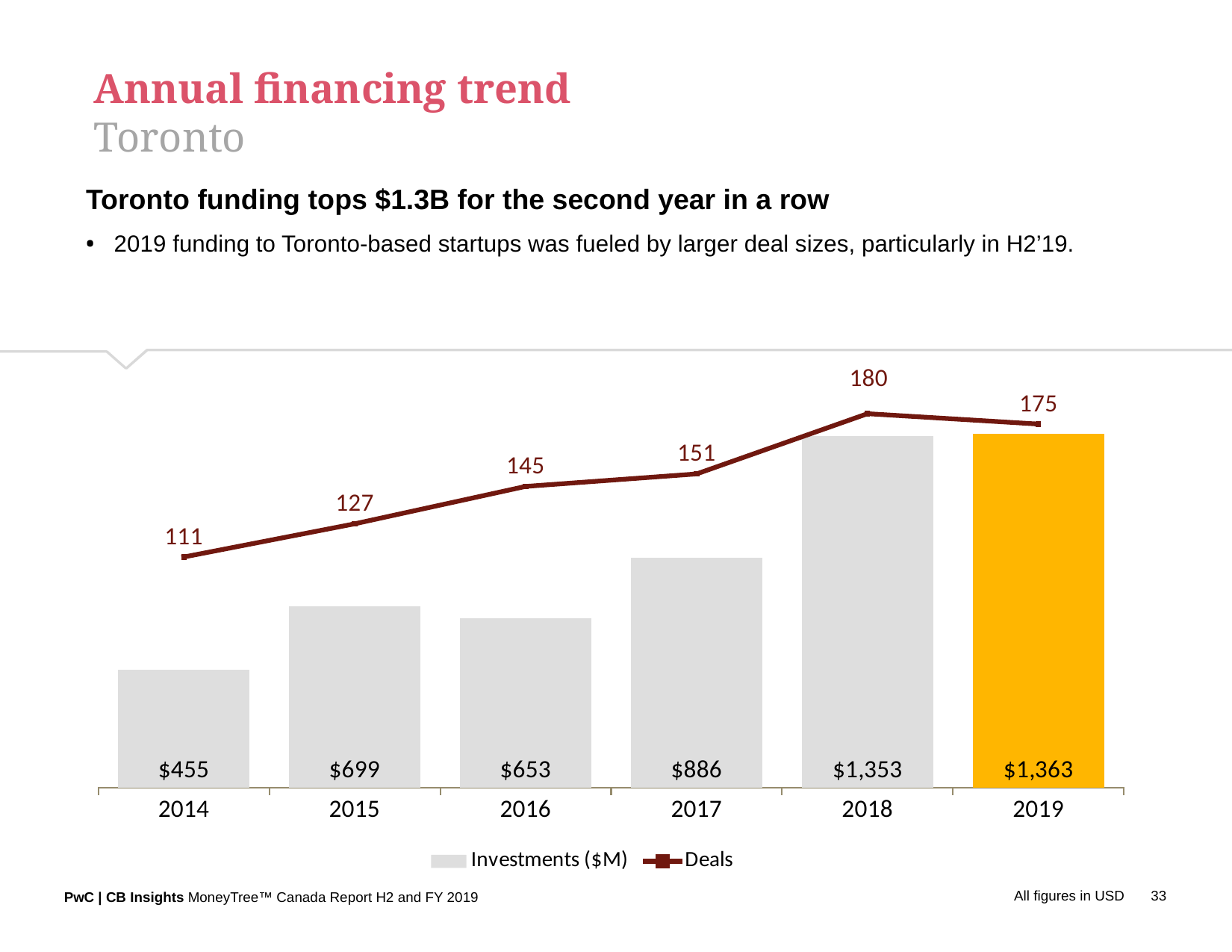
Which year had a higher Investments ($M) value, 2015 or 2016? 2015 What was the Investments ($M) value for Toronto in 2017? $886 Which year had the lowest number of Deals? 2014 How many series does the chart legend list? 2 How many more Deals were there in 2018 than in 2019? 5 Which year had the highest Investments ($M) value? 2019 Which year had more Deals, 2015 or 2017? 2017 How many years are shown on the x axis of the chart? 6 What is the difference in Investments ($M) between 2018 and 2017? $467 How many Deals were recorded in Toronto in 2016? 145 Which year's Investments bar is highlighted in a different colour (yellow) from the others? 2019 What kind of chart is used to show Investments ($M)? Bar chart